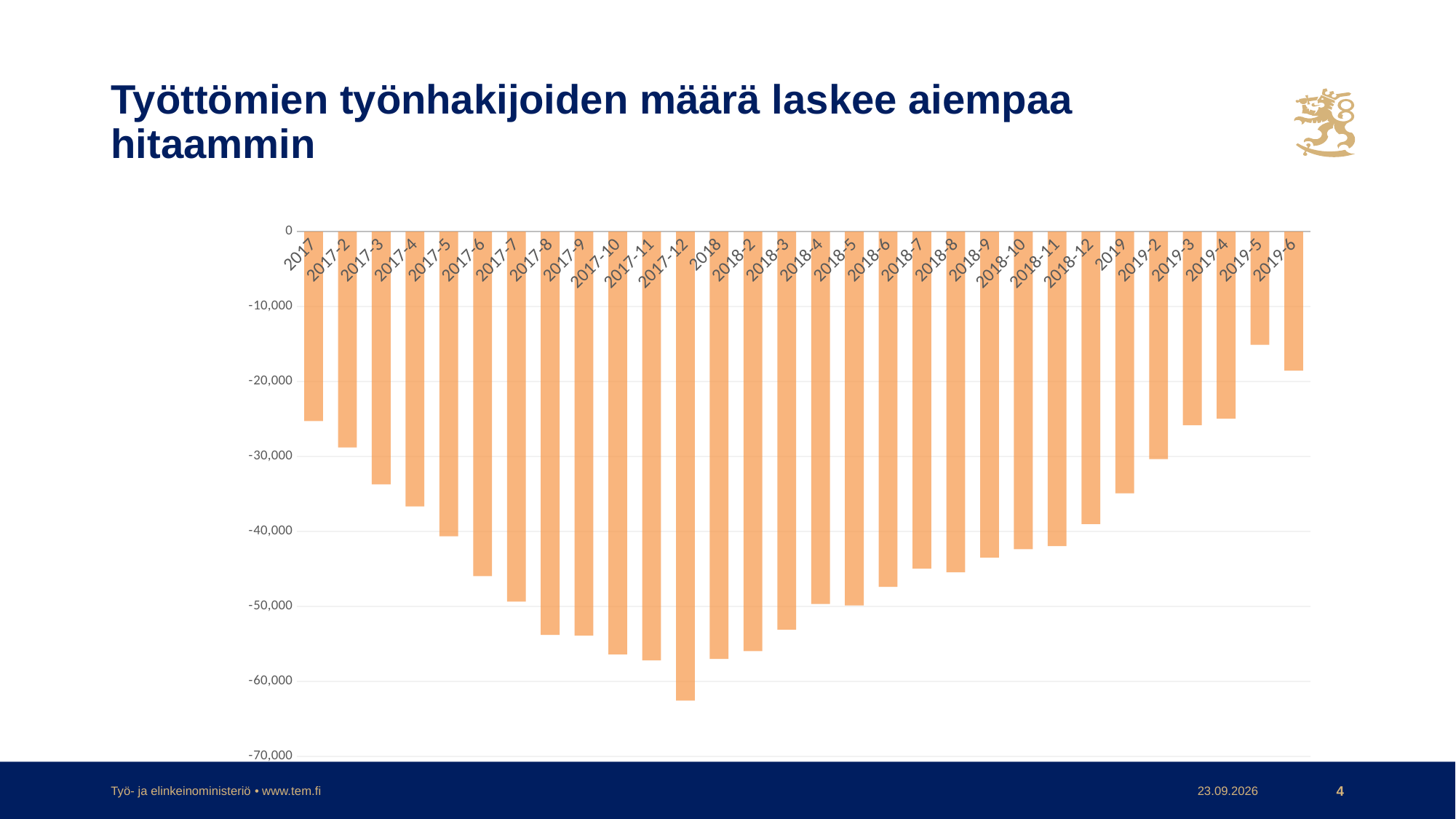
Is the value for 2018-7 greater or less than -50,000? greater What is the title of the slide containing the chart? Työttömien työnhakijoiden määrä laskee aiempaa hitaammin What kind of chart is shown on the slide? bar chart Is the value for 2017-12 greater or less than -60,000? less Which category has the highest value (closest to zero)? 2019-5 Is the value for 2019-5 greater or less than -20,000? greater Which category has the lowest (most negative) value? 2017-12 Which has the larger value, 2017-12 or 2019-6? 2019-6 Which has the larger value, 2017 or 2017-2? 2017 Do the values generally rise or fall from 2017-12 to 2019-5? rise How many bars (categories) does the chart show? 30